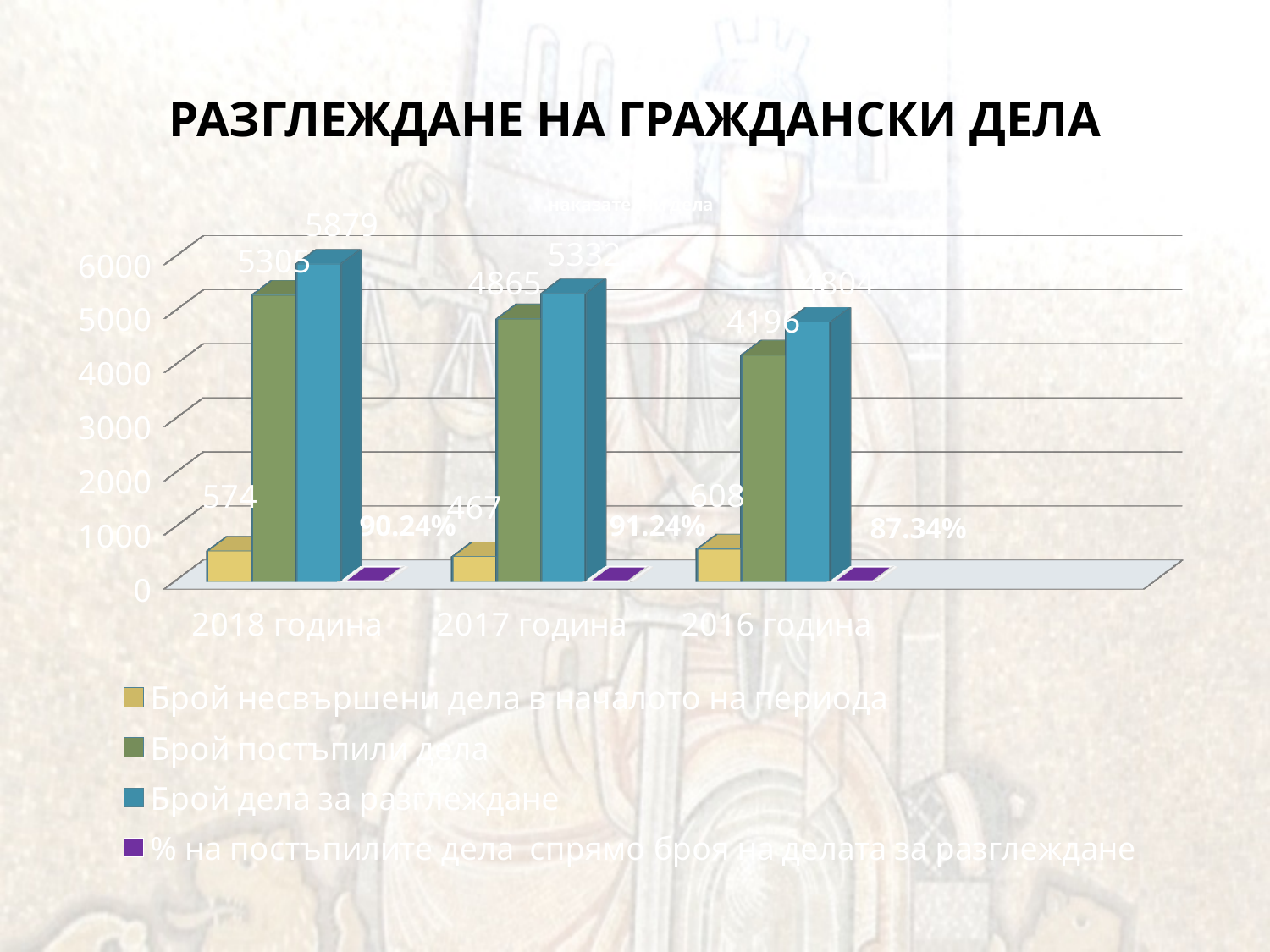
How many series does the legend list? 4 How many year categories are shown on the x axis? 3 What is the difference between Брой дела за разглеждане and Брой постъпили дела for 2016 година? 608 Which is larger: Брой несвършени дела в началото на периода for 2018 година or for 2017 година? 2018 година Is the value of Брой постъпили дела for 2016 година greater or less than 5000? less Which year has the lowest value for Брой постъпили дела? 2016 година What is the value of Брой несвършени дела в началото на периода for 2016 година? 608 What type of chart is shown on the slide? bar chart What is the value of Брой постъпили дела for 2017 година? 4865 What percentage is shown for % на постъпилите дела спрямо броя на делата за разглеждане in 2017 година? 91.24% Which year has the highest value for Брой дела за разглеждане? 2018 година What is the value of Брой дела за разглеждане for 2018 година? 5879